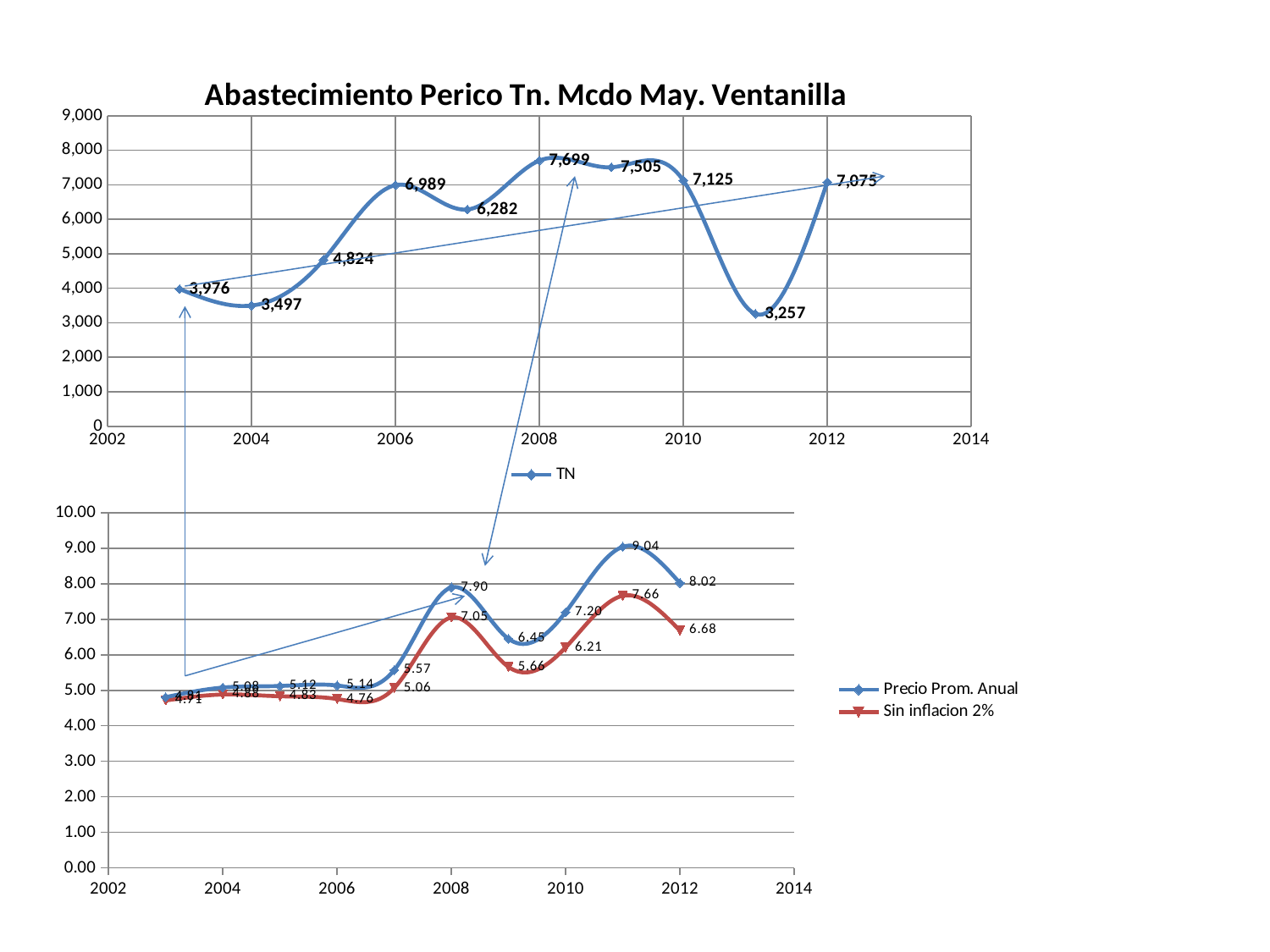
In the top chart 'Abastecimiento Perico Tn. Mcdo May. Ventanilla', is the TN value for 2010 larger than the value for 2012? Yes In the top chart 'Abastecimiento Perico Tn. Mcdo May. Ventanilla', what is the TN value for 2008? 7,699 How many series does the legend of the lower chart list? 2 In the lower chart, what is the value of 'Precio Prom. Anual' for 2011? 9.04 In the lower chart, what is the difference between 'Precio Prom. Anual' and 'Sin inflacion 2%' in 2012? 1.34 In the lower chart, which year has the lowest 'Sin inflacion 2%' value? 2003 What type of chart is the lower chart on the slide? Line chart In the top chart 'Abastecimiento Perico Tn. Mcdo May. Ventanilla', what is the difference between the TN values for 2006 and 2007? 707 In the top chart 'Abastecimiento Perico Tn. Mcdo May. Ventanilla', how many data points are plotted for the TN series? 10 In the top chart 'Abastecimiento Perico Tn. Mcdo May. Ventanilla', which year has the highest TN value? 2008 In the lower chart, what is the value of 'Sin inflacion 2%' for 2008? 7.05 In the top chart 'Abastecimiento Perico Tn. Mcdo May. Ventanilla', which year has the lowest TN value? 2011